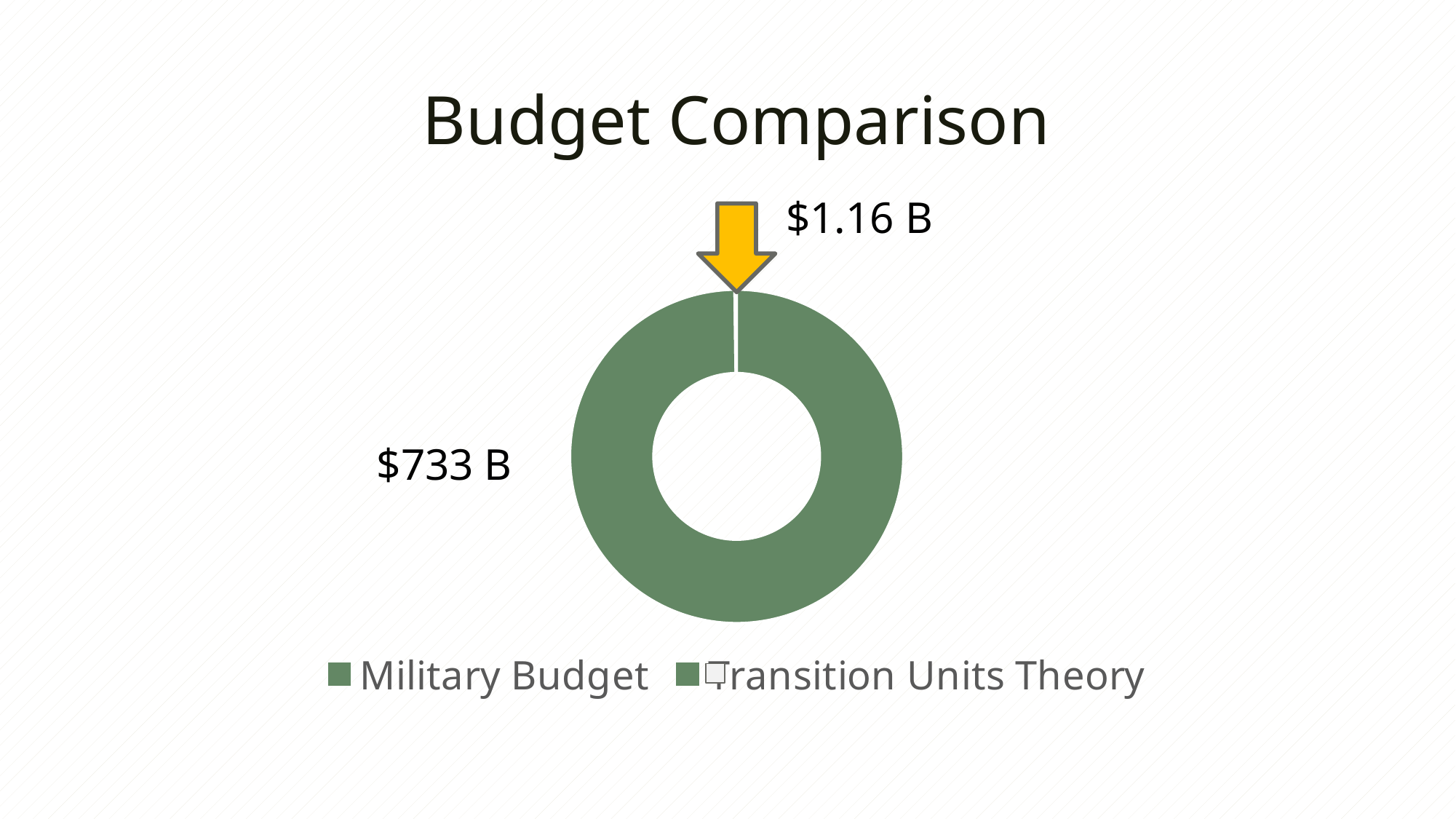
What is the title of the chart? Budget Comparison Which is larger, the Military Budget or Transition Units Theory? Military Budget What is the value shown for Military Budget? $733 B Which category has the smallest value in the chart? Transition Units Theory How many entries does the legend list? 2 What is the value shown for Transition Units Theory? $1.16 B What kind of chart is shown on the slide? doughnut chart What is the combined total of the two values shown in the chart? $734.16 B Which category has the largest value in the chart? Military Budget What is the difference between the Military Budget and Transition Units Theory values? $731.84 B How many categories does the chart show? 2 Which category does the yellow arrow point to? Transition Units Theory